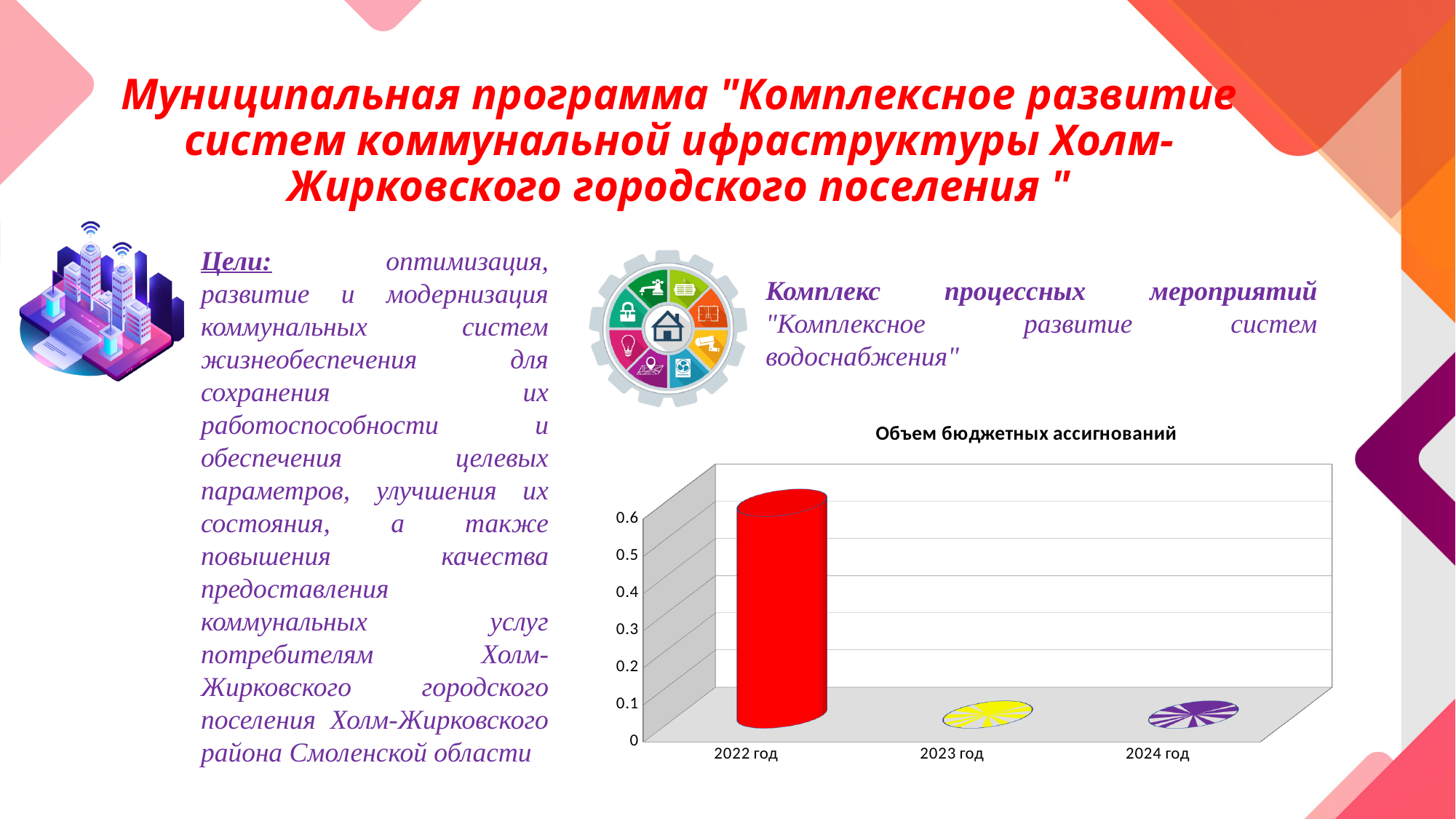
What colour is the bar for 2022 год? red What is the title of the chart? Объем бюджетных ассигнований Which year has the highest value in the chart? 2022 год Is the value for 2024 год greater or less than 0.1? less Which is larger, the value for 2022 год or the value for 2023 год? 2022 год Is the value for 2023 год greater or less than 0.1? less Do the values rise or fall from 2022 год to 2023 год? fall How many categories are shown on the x axis of the chart? 3 Is the value for 2022 год greater or less than 0.4? greater What kind of chart is shown under the title "Объем бюджетных ассигнований"? bar chart Which is larger, the value for 2022 год or the value for 2024 год? 2022 год